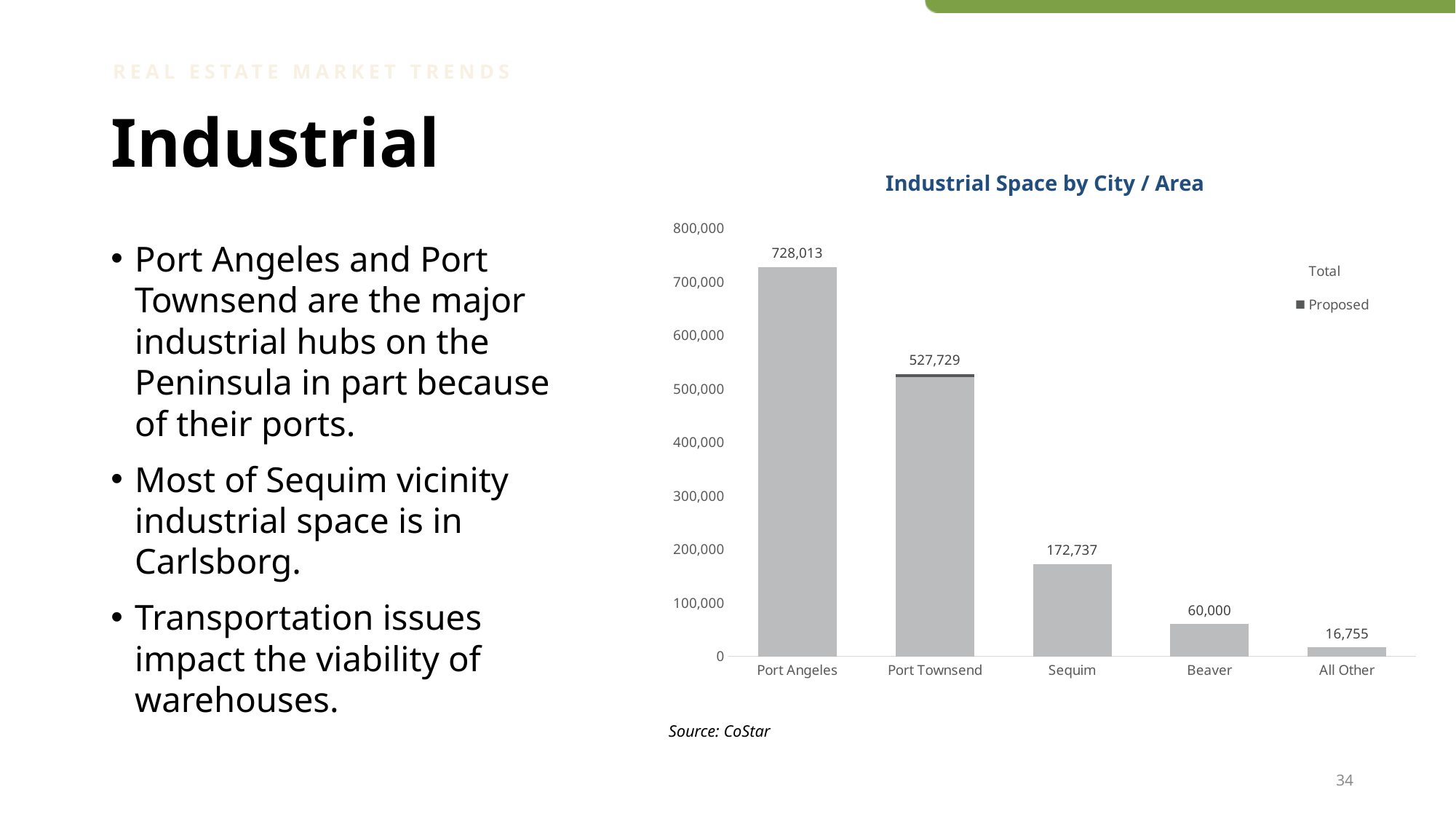
What value is labelled for All Other? 16,755 What is the difference between the labelled values for Sequim and Beaver? 112,737 How many series does the legend list? 2 What type of chart is shown on the slide? Bar chart What is the difference between the labelled values for Port Angeles and Port Townsend? 200,284 What value is labelled for Port Angeles? 728,013 What value is labelled for Sequim? 172,737 Which city or area has the lowest industrial space? All Other Which city or area has the highest industrial space? Port Angeles Which is larger, the value for Beaver or the value for All Other? Beaver How many cities or areas are shown on the x axis? 5 What is the title of the chart? Industrial Space by City / Area